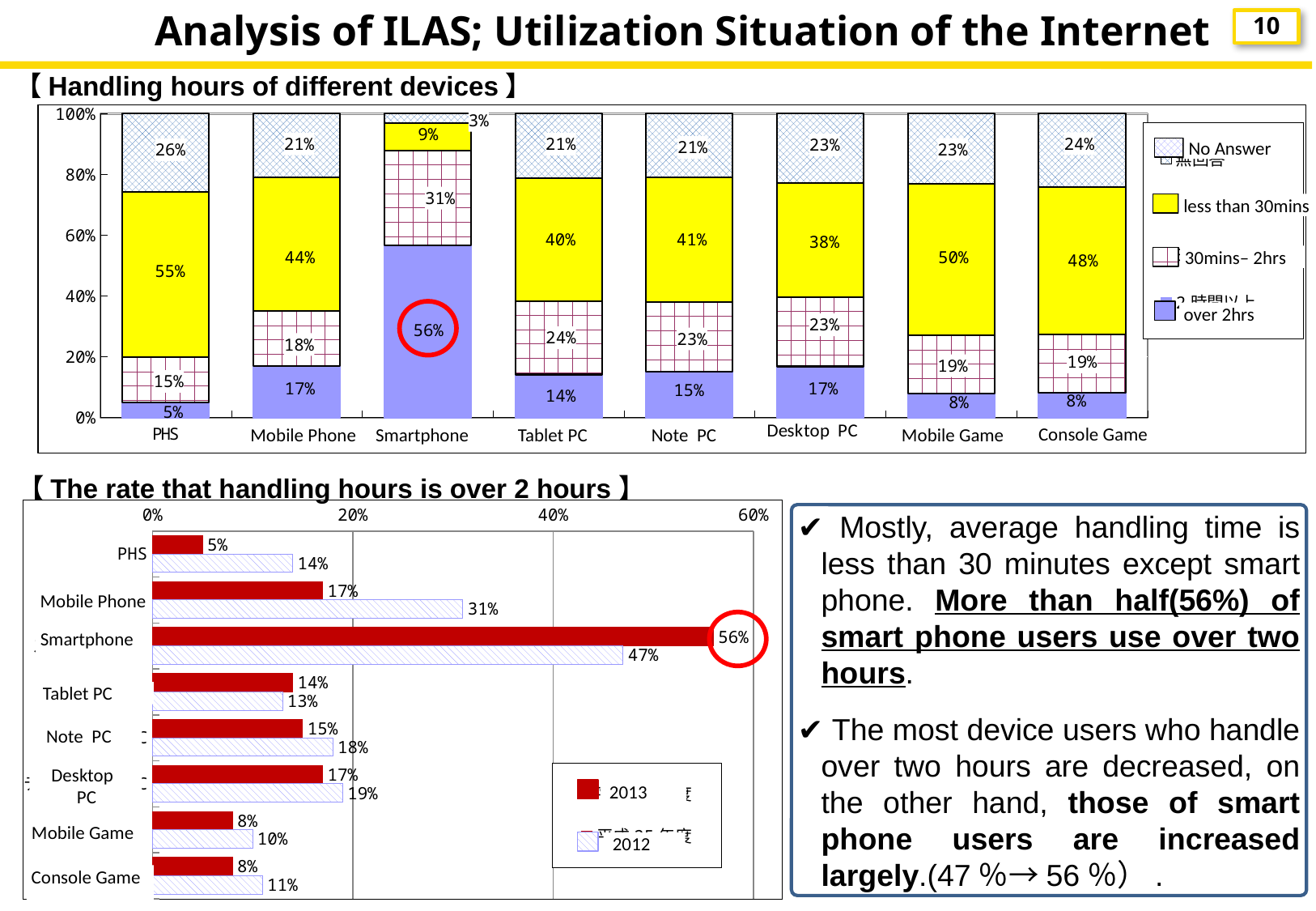
In the 'Handling hours of different devices' chart, what is the difference between the 'less than 30mins' shares of Mobile Game and Console Game? 2% In the 'The rate that handling hours is over 2 hours' chart, how many devices are listed? 8 In the 'The rate that handling hours is over 2 hours' chart, what kind of chart is shown? Bar chart In the 'Handling hours of different devices' chart, what is the 'less than 30mins' share for PHS? 55% In the 'Handling hours of different devices' chart, what percentage of Smartphone users handle the device for over 2 hours? 56% In the 'The rate that handling hours is over 2 hours' chart, by how much did the Smartphone value increase from 2012 to 2013? 9% In the 'Handling hours of different devices' chart, which device has the lowest 'over 2hrs' share? PHS In the 'The rate that handling hours is over 2 hours' chart, what is the 2013 value for Mobile Phone? 17% In the 'Handling hours of different devices' chart, how many series does the legend list? 4 In the 'Handling hours of different devices' chart, which device has the highest 'over 2hrs' share? Smartphone In the 'The rate that handling hours is over 2 hours' chart, what is the 2012 value for Smartphone? 47% In the 'The rate that handling hours is over 2 hours' chart, which is larger for Mobile Phone: the 2013 value or the 2012 value? 2012